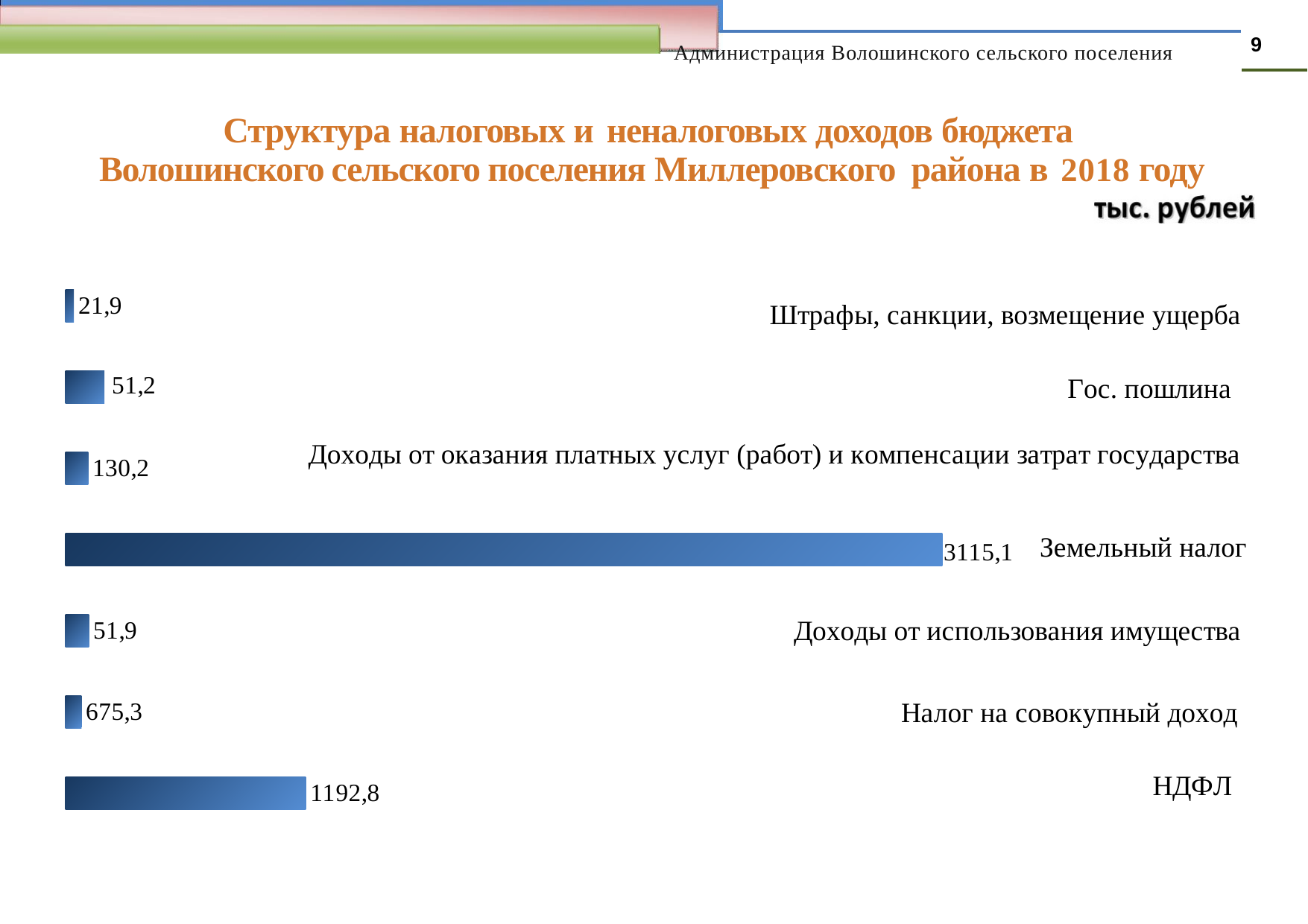
What is the value for Налог на совокупный доход? 675,3 Which category has the highest value? Земельный налог Which category has the lowest value? Штрафы, санкции, возмещение ущерба In what units are the chart values given? тыс. рублей What is the value for Доходы от оказания платных услуг (работ) и компенсации затрат государства? 130,2 What is the value for Штрафы, санкции, возмещение ущерба? 21,9 What type of chart is shown on the slide? bar chart What is the value for Земельный налог? 3115,1 What is the difference between the values for Земельный налог and НДФЛ? 1922,3 Which is larger, the value for НДФЛ or the value for Налог на совокупный доход? НДФЛ What is the value for НДФЛ? 1192,8 How many categories are shown in the chart? 7